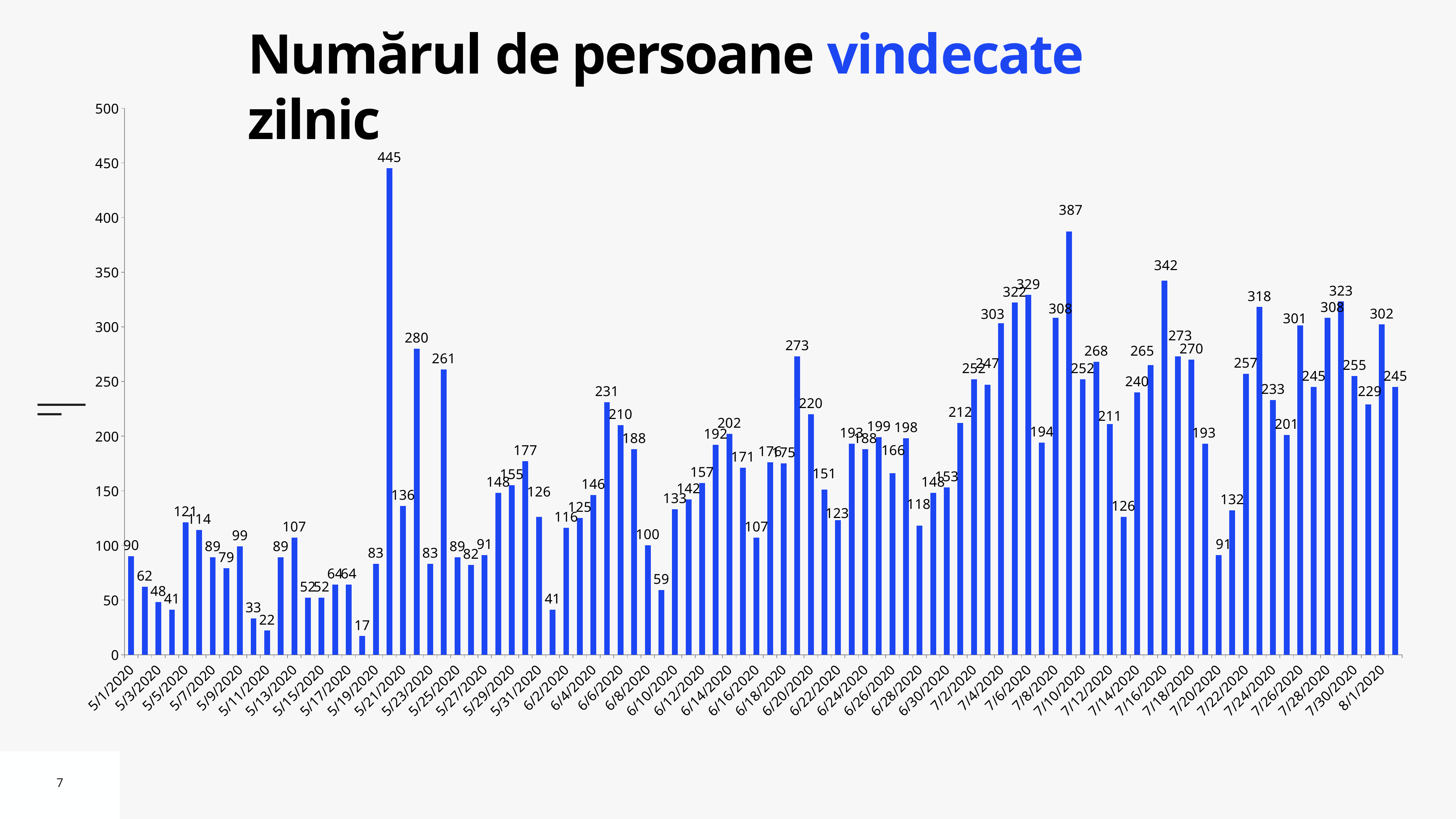
What kind of chart is shown on the slide? bar chart Is the value for 7/20/2020 greater or less than 100? less Which date has the larger value, 5/5/2020 or 5/13/2020? 5/5/2020 What is the value for 5/5/2020? 121 What is the title of the chart? Numărul de persoane vindecate zilnic What is the difference between the values for 7/8/2020 and 7/16/2020? 34 What is the value for 7/8/2020? 308 What is the value for 5/1/2020? 90 Do the daily values generally rise or fall from May to July? rise What is the lowest daily value shown in the chart? 17 What is the highest daily value shown in the chart? 445 What is the value for 7/16/2020? 342